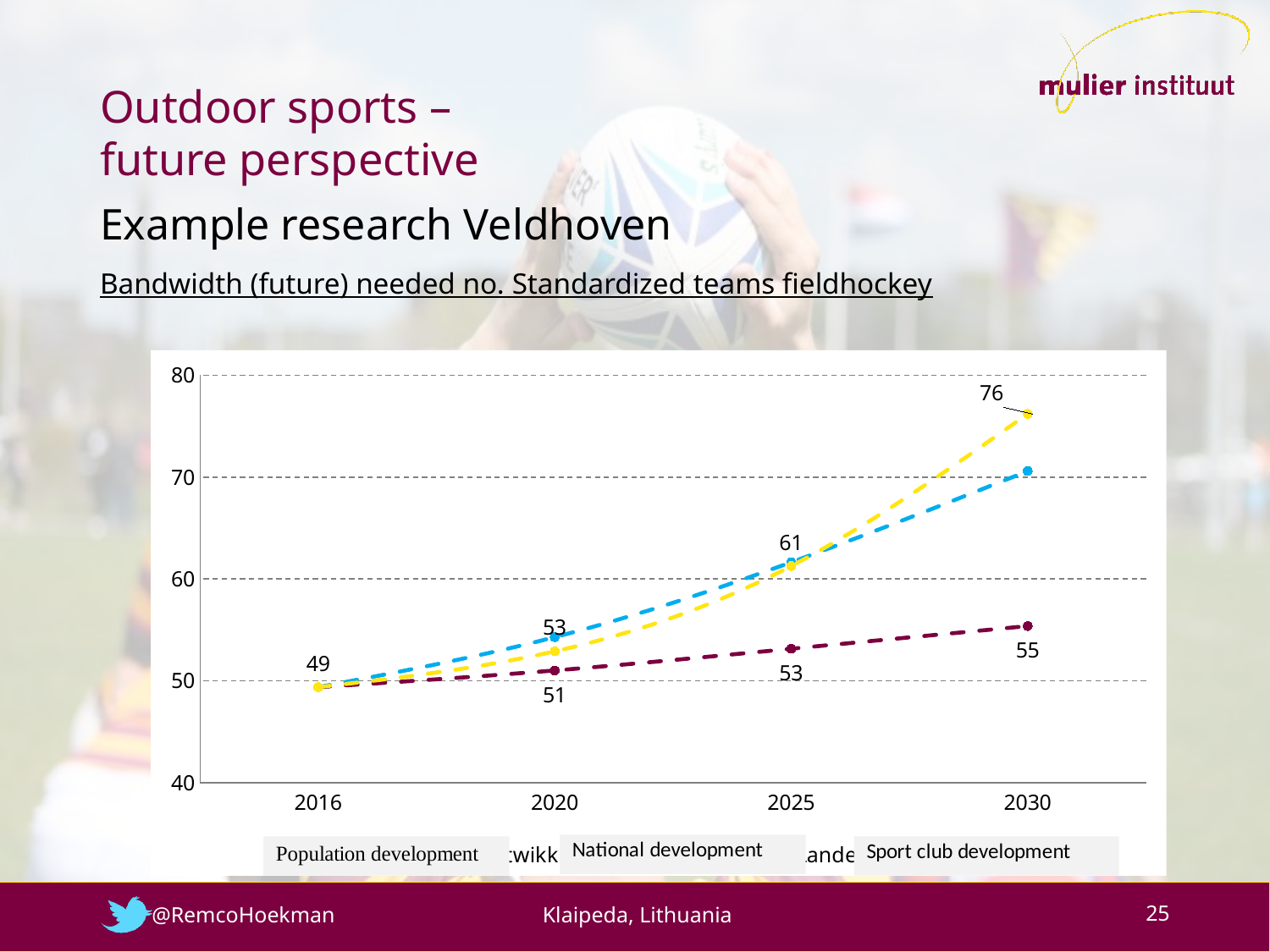
What is the value of the yellow line in 2030? 76 Is the value of the blue line in 2025 greater or less than 60? greater What is the value of the dark red line in 2020? 51 By how much does the yellow line increase from 2016 to 2030? 27 What is the value of the yellow line in 2016? 49 Does the yellow line rise or fall from 2016 to 2030? rise What is the difference between the yellow line and the dark red line in 2025? 8 In 2030, which line has the higher value, the yellow line or the dark red line? yellow line What is the value of the dark red line in 2030? 55 How many years are shown on the x axis of the chart? 4 How many series does the chart's legend list? 3 What kind of chart is shown on the slide? line chart